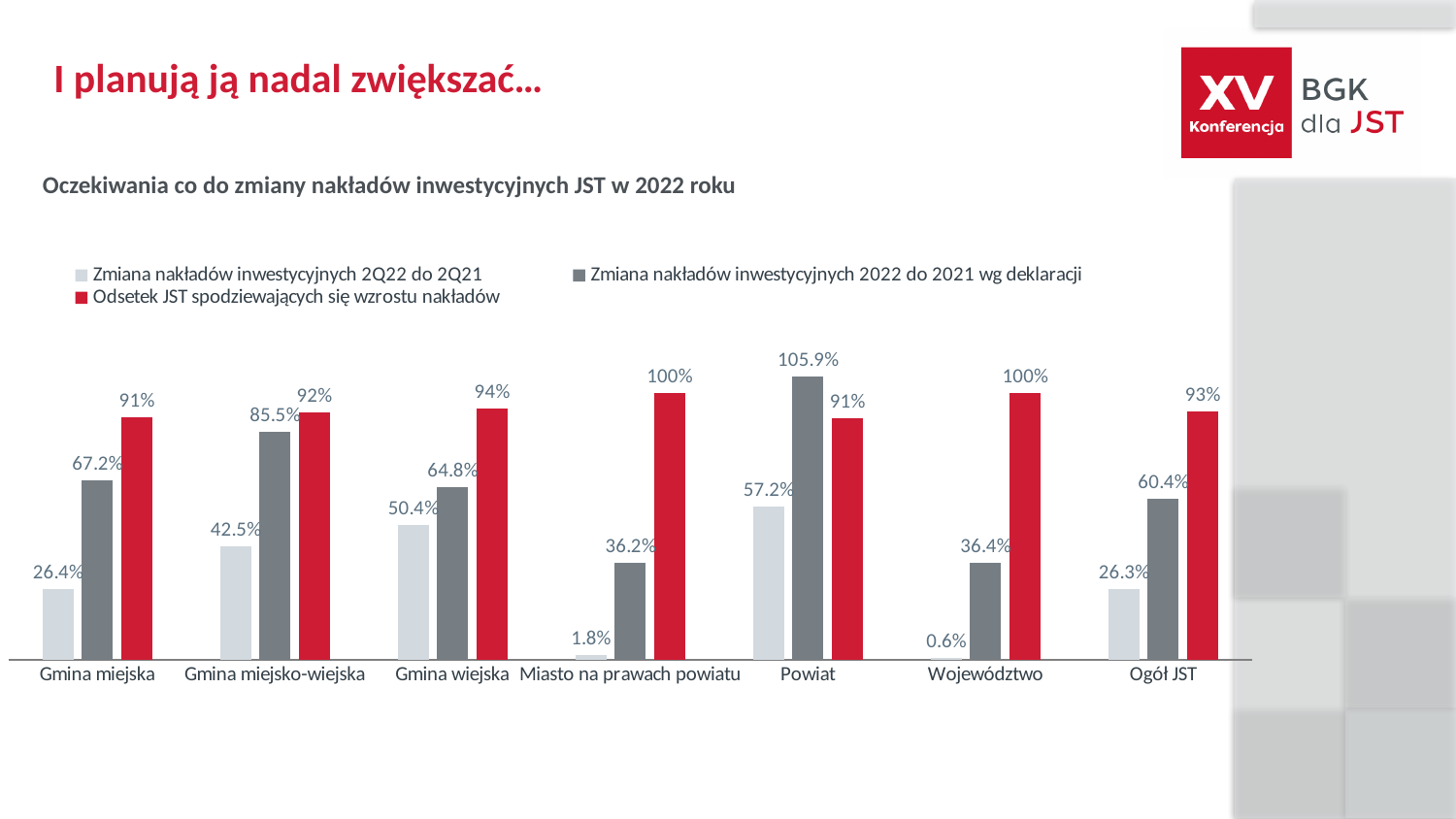
How many series does the legend list? 3 Which category has the lowest value for 'Zmiana nakładów inwestycyjnych 2Q22 do 2Q21'? Województwo Which series is shown in red? Odsetek JST spodziewających się wzrostu nakładów What kind of chart is shown on the slide? bar chart Which category has the highest value for 'Zmiana nakładów inwestycyjnych 2022 do 2021 wg deklaracji'? Powiat What is the title of the chart? Oczekiwania co do zmiany nakładów inwestycyjnych JST w 2022 roku What is the value of 'Zmiana nakładów inwestycyjnych 2Q22 do 2Q21' for Gmina wiejska? 50.4% What is the difference between the 'Zmiana nakładów inwestycyjnych 2022 do 2021 wg deklaracji' value and the 'Zmiana nakładów inwestycyjnych 2Q22 do 2Q21' value for Gmina miejsko-wiejska? 43 percentage points Which is larger: the 'Zmiana nakładów inwestycyjnych 2Q22 do 2Q21' value for Gmina miejska or for Ogół JST? Gmina miejska What is the value of 'Zmiana nakładów inwestycyjnych 2022 do 2021 wg deklaracji' for Powiat? 105.9% What is the value of 'Odsetek JST spodziewających się wzrostu nakładów' for Ogół JST? 93% How many categories are shown on the x axis? 7